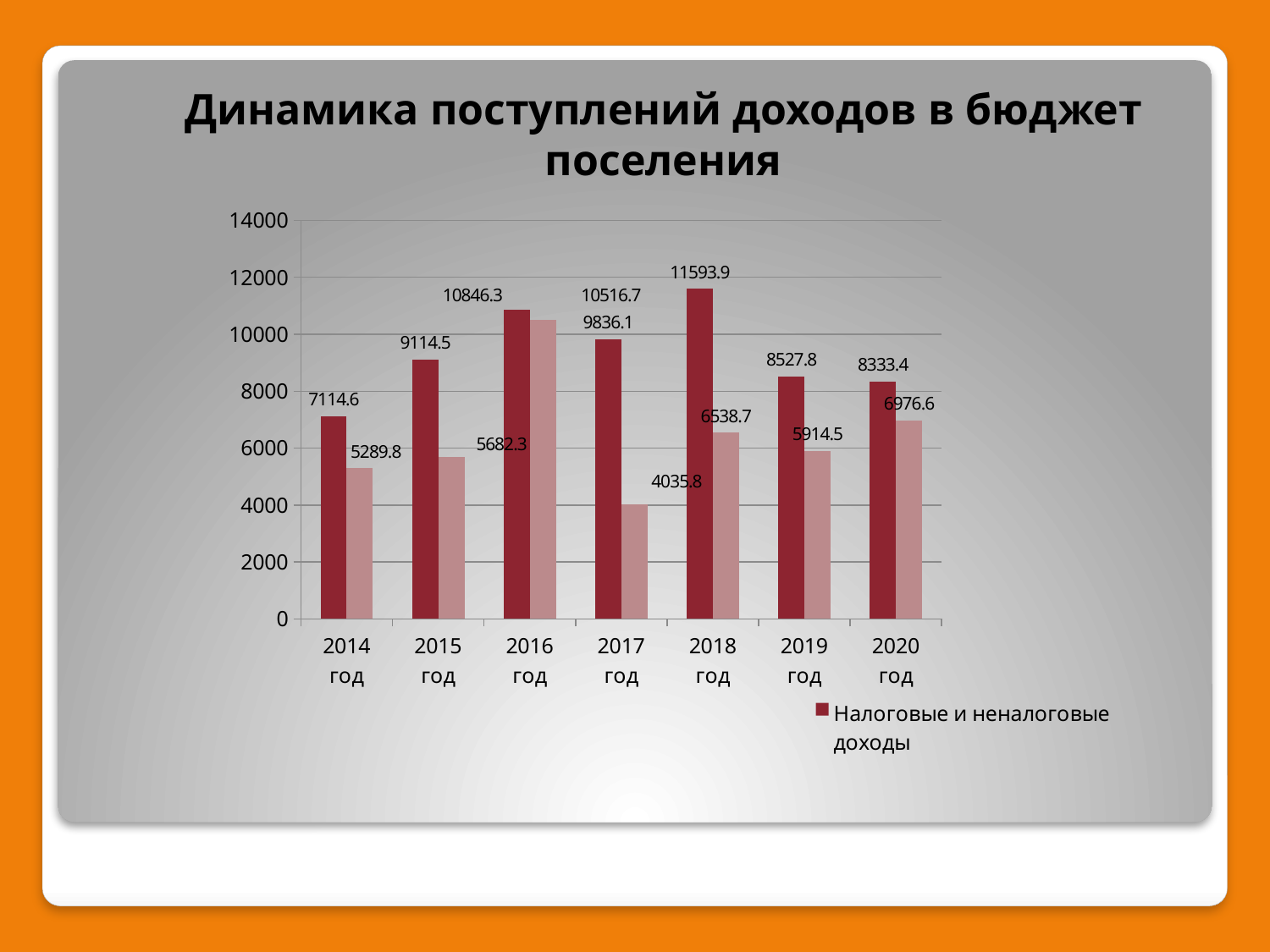
What is the value of Налоговые и неналоговые доходы for 2018 год? 11593.9 In which year is Налоговые и неналоговые доходы highest? 2018 год In which year is Налоговые и неналоговые доходы lowest? 2014 год Is the value of Налоговые и неналоговые доходы for 2019 год greater or less than 8000? greater Which is larger for Налоговые и неналоговые доходы: 2016 год or 2017 год? 2016 год What kind of chart is shown on the slide? bar chart What is the title of the chart? Динамика поступлений доходов в бюджет поселения What is the value of Налоговые и неналоговые доходы for 2014 год? 7114.6 How many series does the legend list? 1 How many years are shown on the x axis? 7 What is the difference between Налоговые и неналоговые доходы in 2018 год and 2014 год? 4479.3 What is the value of Налоговые и неналоговые доходы for 2020 год? 8333.4